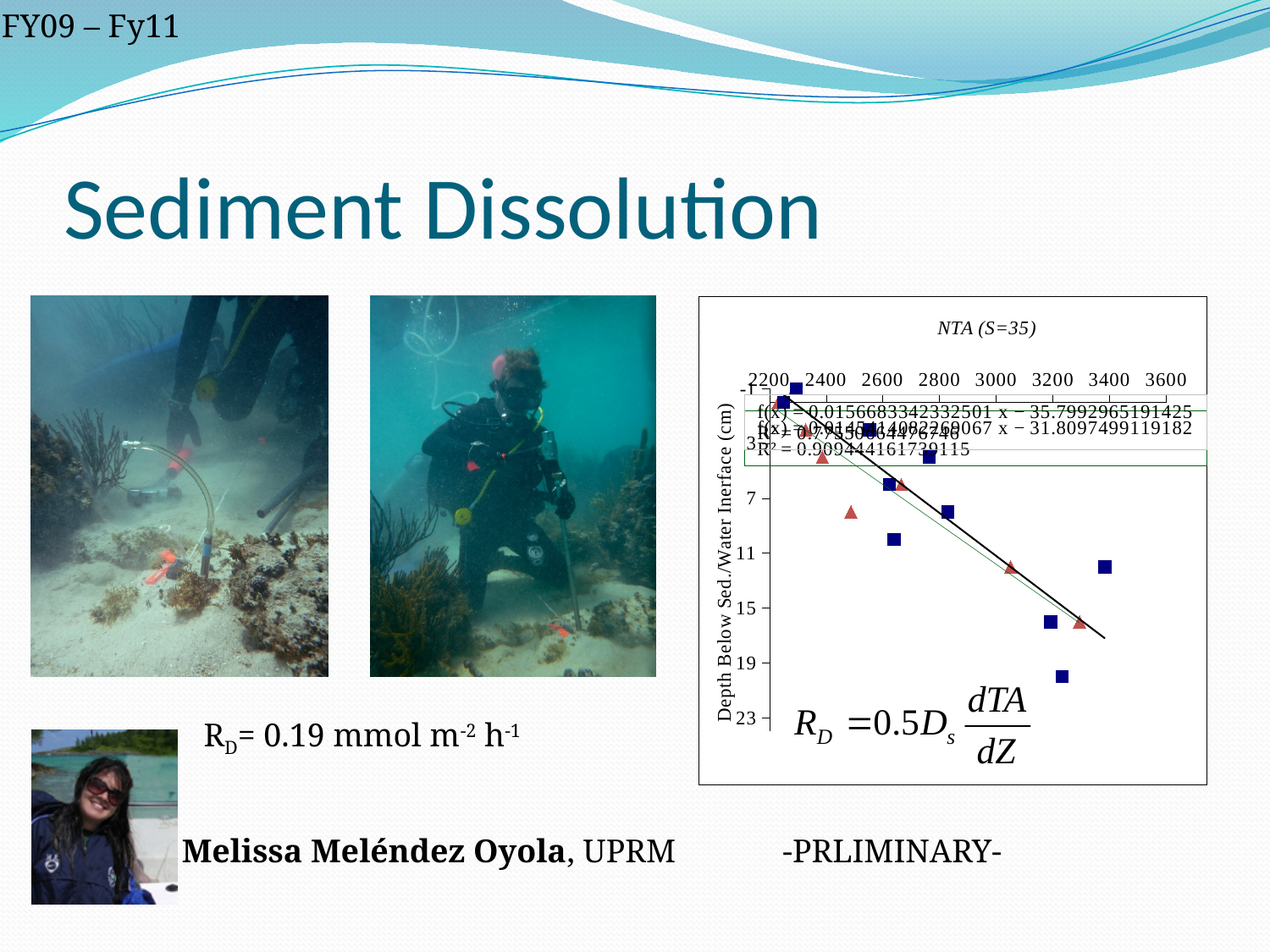
What is the label of the vertical axis of the chart? Depth Below Sed./Water Interface (cm) Do the fitted trend lines in the chart slope upward or downward from left to right? Downward What is the title of the chart on the right of the slide? NTA (S=35) What is the lowest tick value shown on the horizontal axis of the chart? 2200 How many fitted trend lines are drawn on the chart? 2 What is the largest tick value shown on the vertical axis of the chart? 23 Is the depth value of the blue square plotted furthest to the right (near NTA 3400) greater or less than 15 cm? less Is the depth value of the lowest blue square on the chart greater or less than 19 cm? greater What is the highest tick value shown on the horizontal axis of the chart? 3600 As NTA increases along the horizontal axis, does the depth below the sediment/water interface increase or decrease? Increase What kind of chart is shown on the right of the slide? Scatter chart